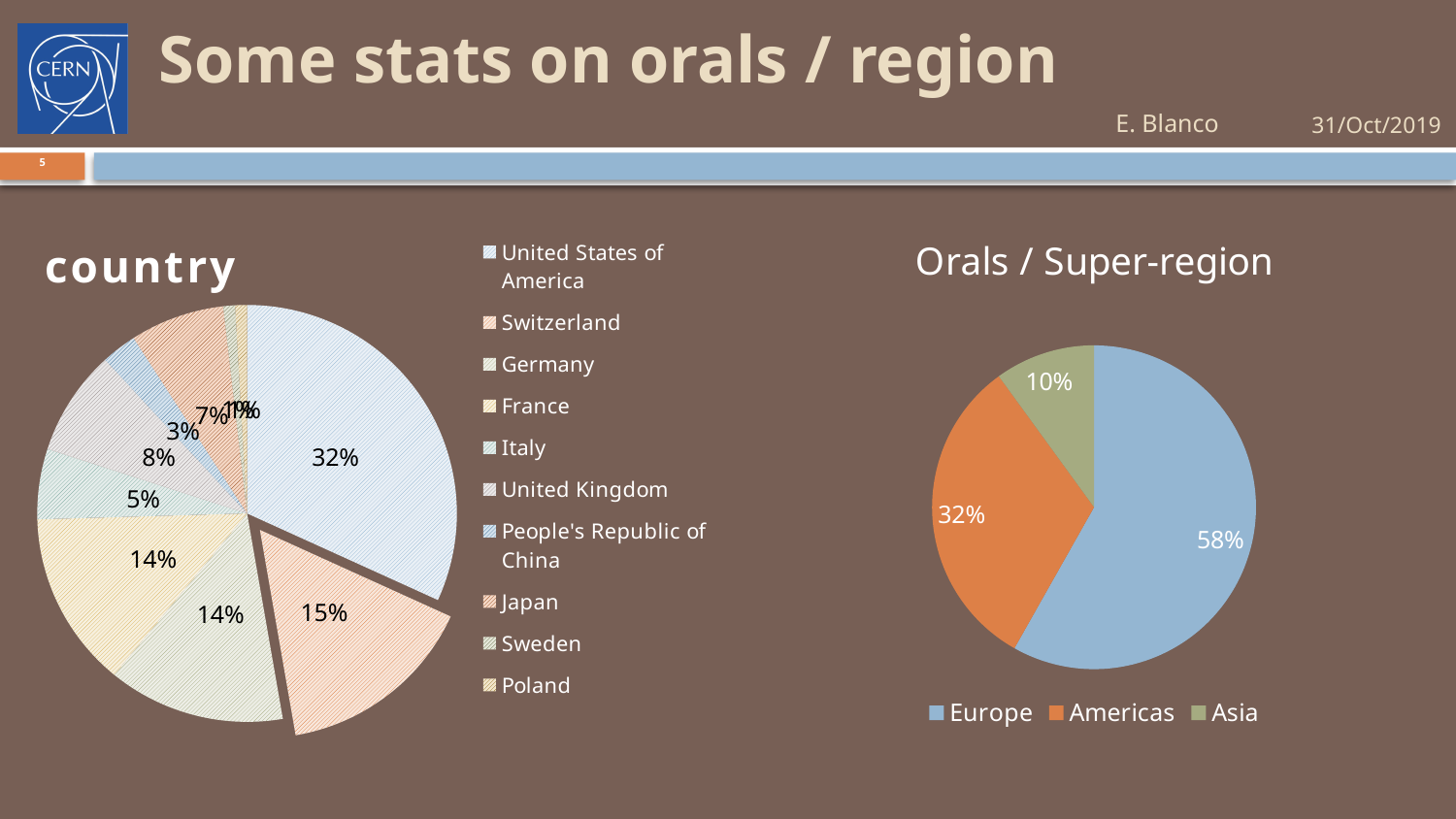
On the 'Orals / Super-region' chart, what share of orals is Europe? 58% On the 'country' chart, how many countries are listed in the legend? 10 On the 'country' chart, what share does the exploded slice for Switzerland have? 15% What kind of chart is the 'Orals / Super-region' chart? Pie chart On the 'Orals / Super-region' chart, what is the difference in percentage points between Europe and Americas? 26 On the 'Orals / Super-region' chart, what share of orals is Asia? 10% On the 'country' chart, which country has the largest share? United States of America On the 'country' chart, what share does the United States of America have? 32% On the 'Orals / Super-region' chart, what share of orals is Americas? 32% On the 'Orals / Super-region' chart, which region has the largest share? Europe On the 'Orals / Super-region' chart, which region has the smallest share? Asia On the 'Orals / Super-region' chart, how many regions are listed in the legend? 3